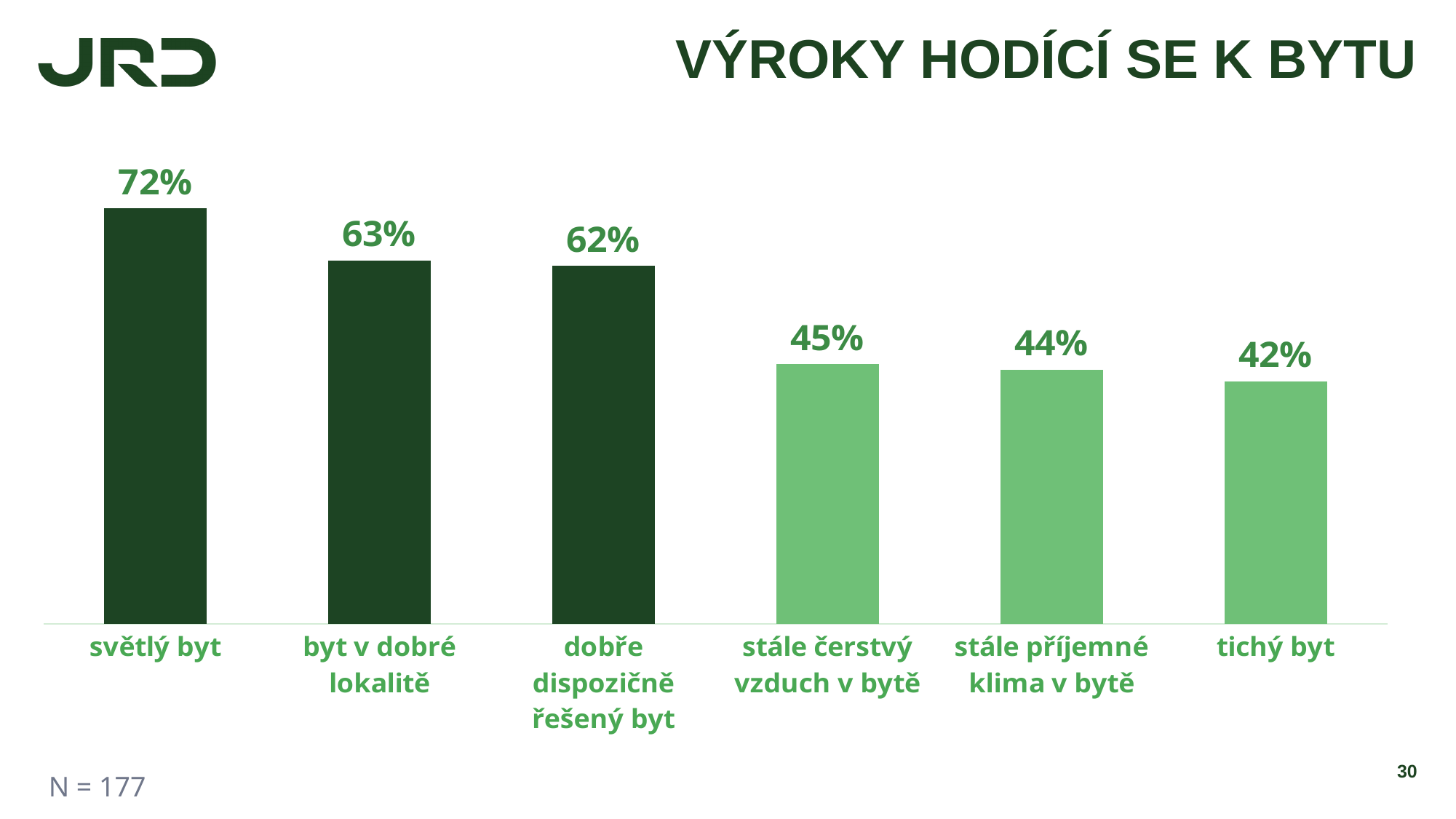
What is the difference between the values for "byt v dobré lokalitě" and "stále čerstvý vzduch v bytě"? 18% What kind of chart is shown on the slide? bar chart What is the value for "dobře dispozičně řešený byt"? 62% Which is larger, the value for "byt v dobré lokalitě" or the value for "stále příjemné klima v bytě"? byt v dobré lokalitě Which category has the lowest value? tichý byt How many categories are shown in the chart? 6 What is the title of the chart? VÝROKY HODÍCÍ SE K BYTU What is the value for "světlý byt"? 72% What is the difference between the values for "světlý byt" and "tichý byt"? 30% Do the values rise or fall from left to right along the x axis? fall What is the value for "stále příjemné klima v bytě"? 44% Which category has the highest value? světlý byt